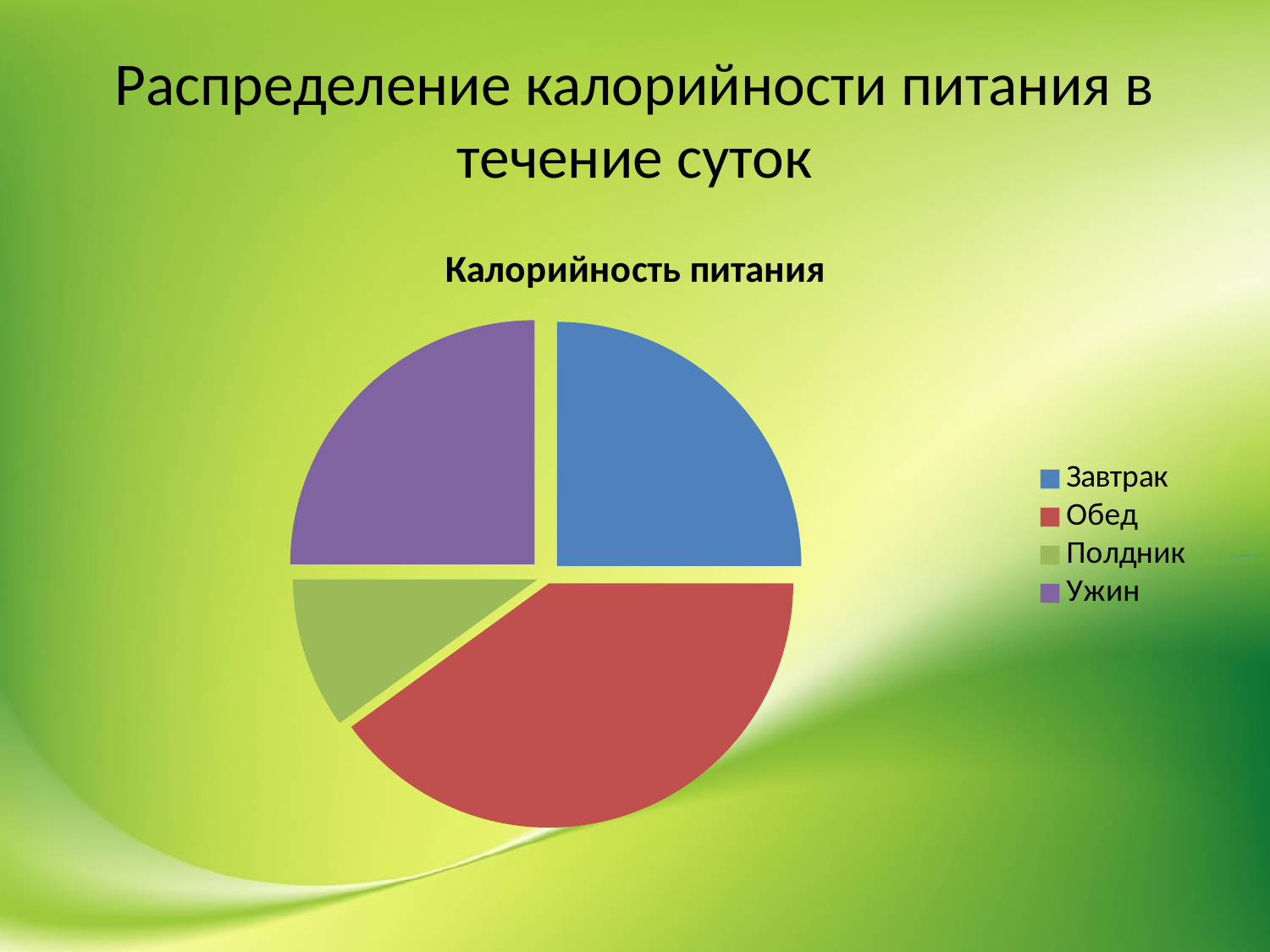
Which slice is smaller, Полдник or Обед? Полдник How many entries does the legend list? 4 Which category has the largest slice of the pie? Обед Which slice is larger, Обед or Завтрак? Обед How many slices does the pie chart have? 4 What is the title of the chart? Калорийность питания Which slice is larger, Ужин or Полдник? Ужин Which category has the smallest slice of the pie? Полдник What colour is the slice for Обед? Red What kind of chart is shown on the slide? Pie chart